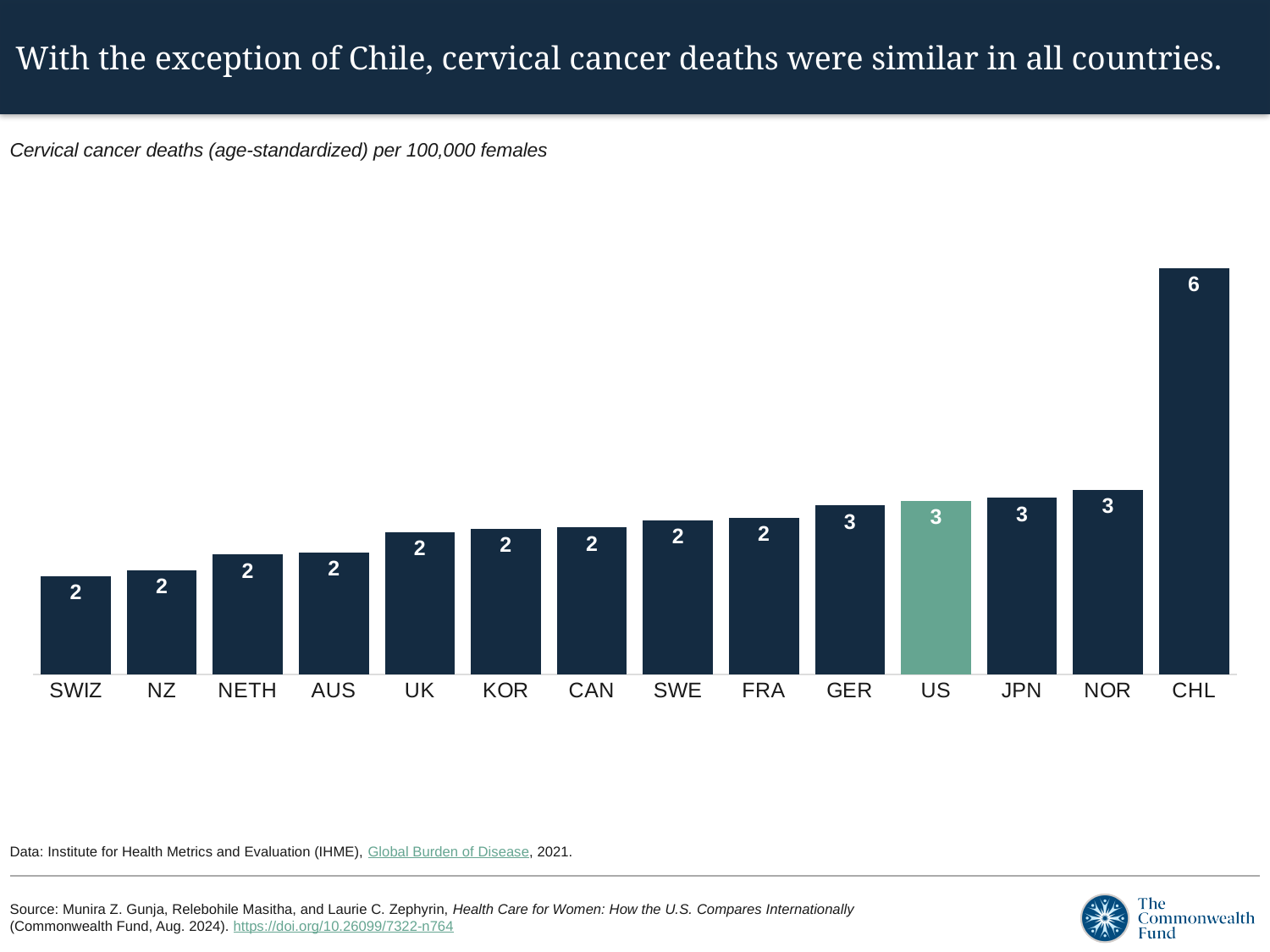
What is the difference between the values for CHL and SWIZ? 4 Do the values generally rise or fall from left to right along the x axis? Rise What is the value for the US? 3 Which country's bar is shown in a different colour from the others? US Which country has the highest value? CHL What is the difference between the values for CHL and the US? 3 Which is larger, the value for CHL or the value for GER? CHL What kind of chart is shown on the slide? Bar chart What is the value for SWIZ? 2 What is the value for CHL? 6 What is the value for NOR? 3 How many countries are shown on the chart? 14